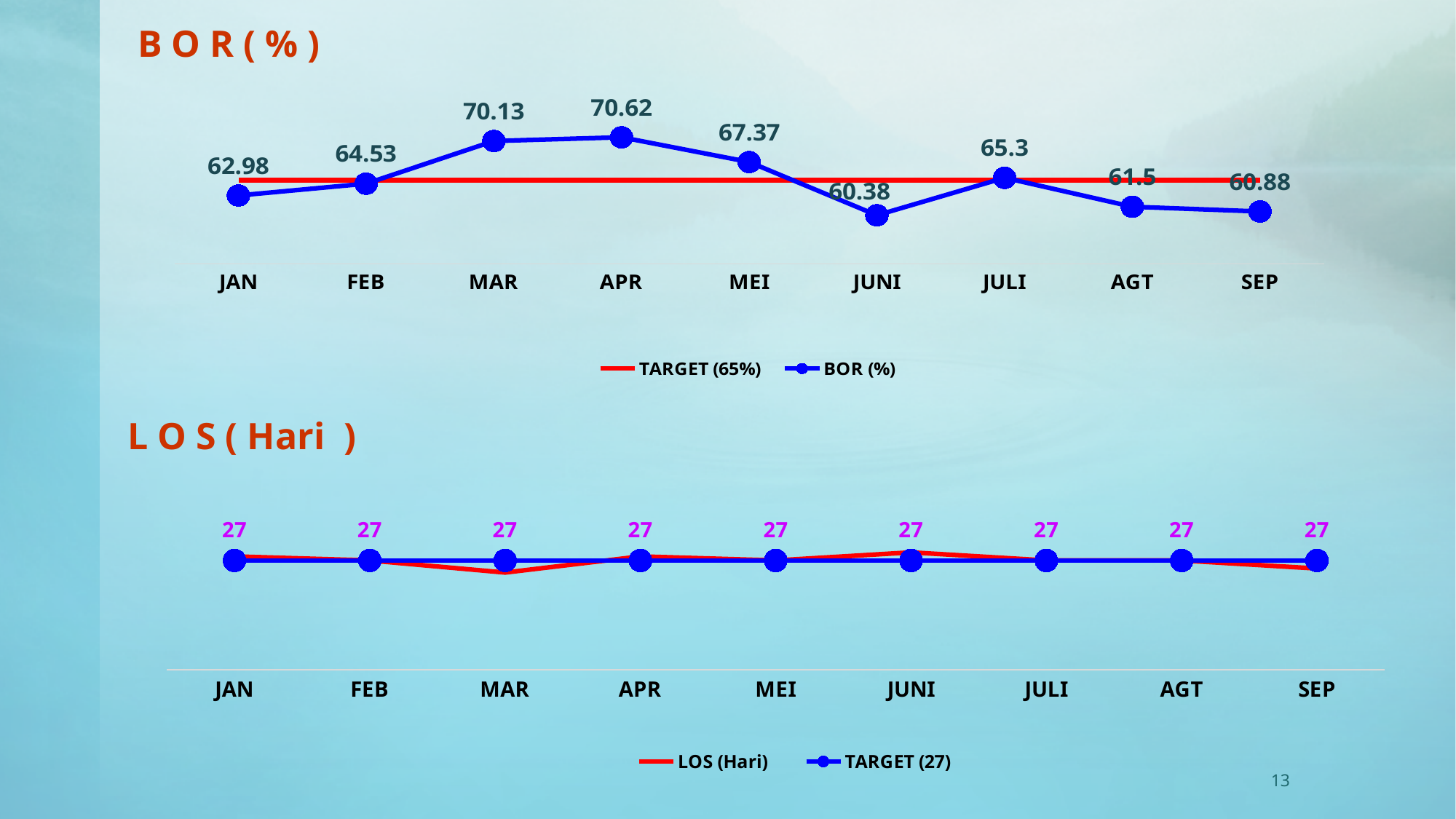
In the BOR (%) chart, what is the difference between the BOR values for MAR and JAN? 7.15 In the BOR (%) chart, how many months are plotted on the x axis? 9 In the BOR (%) chart, which is larger, the BOR value for MEI or for JULI? MEI In the LOS (Hari) chart, what is the TARGET value shown for SEP? 27 In the BOR (%) chart, how many series does the legend list? 2 In the BOR (%) chart, what is the BOR value for MAR? 70.13 What kind of chart is the LOS (Hari) chart? line chart In the BOR (%) chart, what is the BOR value for JUNI? 60.38 In the BOR (%) chart, which month has the lowest BOR value? JUNI In the BOR (%) chart, which month has the highest BOR value? APR In the BOR (%) chart, do the BOR values rise or fall from JAN to APR? rise In the BOR (%) chart, what target value is named in the legend for the red line? TARGET (65%)